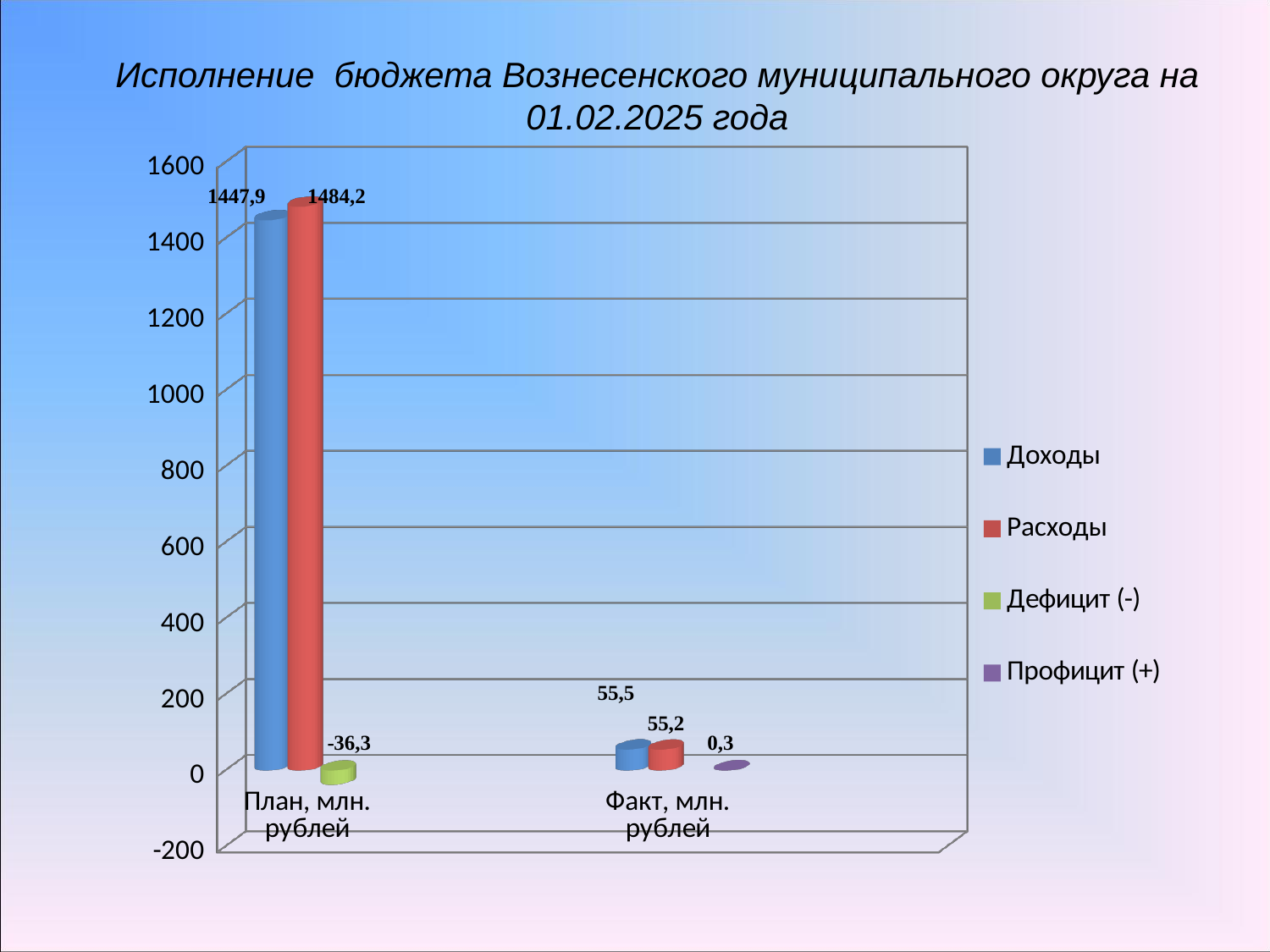
What kind of chart is shown on the slide? Bar chart What is the value of Расходы for Факт, млн. рублей? 55,2 How many categories are shown on the x axis? 2 What is the value of Доходы for План, млн. рублей? 1447,9 What is the value of Профицит (+) for Факт, млн. рублей? 0,3 What is the value of Расходы for План, млн. рублей? 1484,2 Which series has the highest value in the План, млн. рублей category? Расходы What is the value of Дефицит (-) for План, млн. рублей? -36,3 Which is larger for План, млн. рублей: Доходы or Расходы? Расходы How many series does the legend list? 4 What is the value of Доходы for Факт, млн. рублей? 55,5 What is the difference between Расходы and Доходы for План, млн. рублей? 36,3